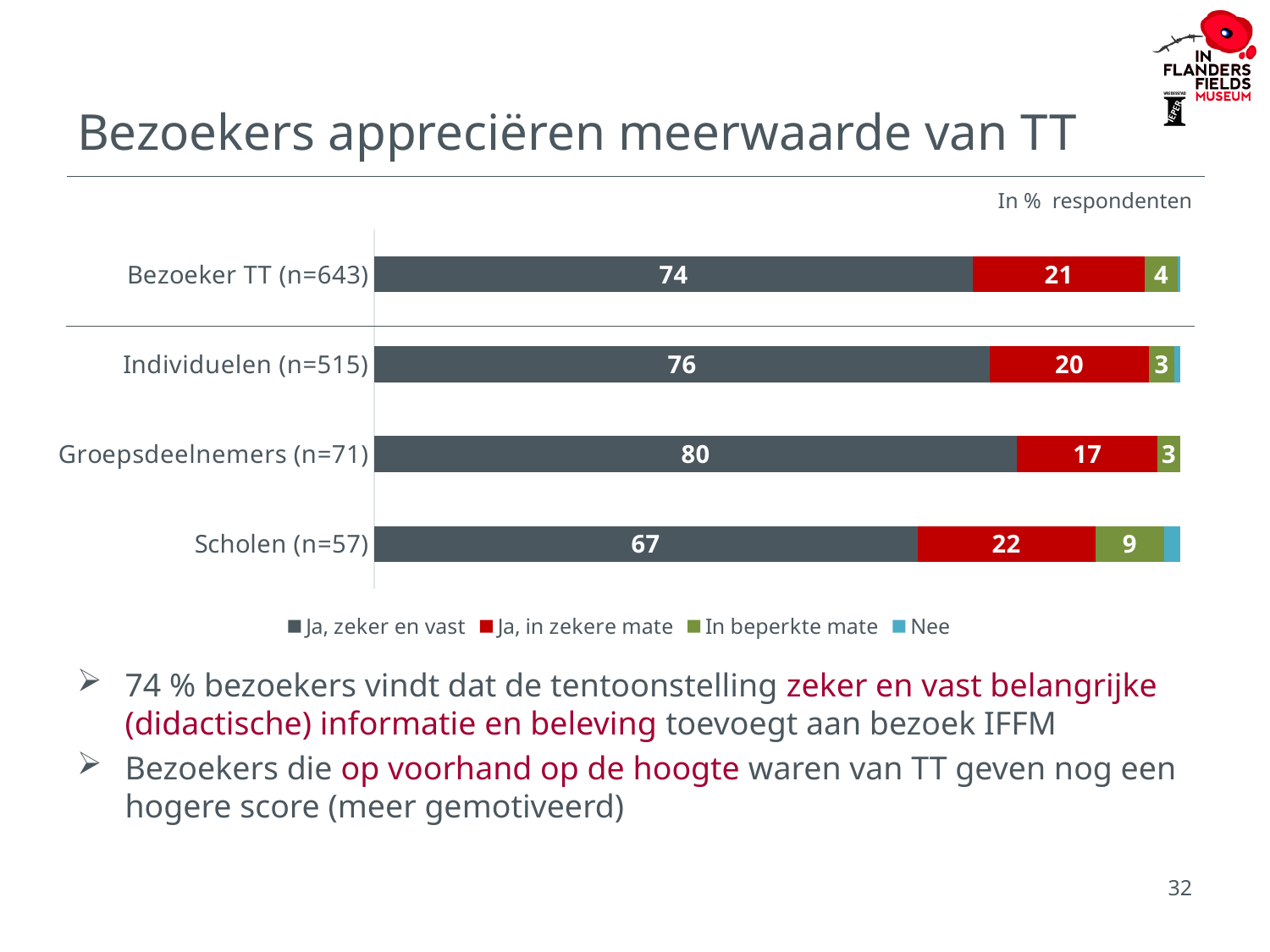
What is the value for "Ja, in zekere mate" for Scholen (n=57)? 22 Which category has the highest value for "Ja, zeker en vast"? Groepsdeelnemers (n=71) Which category has the lowest value for "Ja, zeker en vast"? Scholen (n=57) What is the value for "Ja, zeker en vast" for Bezoeker TT (n=643)? 74 What is the difference between the "Ja, zeker en vast" values for Groepsdeelnemers (n=71) and Scholen (n=57)? 13 What kind of chart is shown on the slide? Stacked bar chart How many series does the legend list? 4 What is the value for "Ja, in zekere mate" for Groepsdeelnemers (n=71)? 17 How many categories are shown on the chart? 4 Which series is shown in red in the chart? Ja, in zekere mate What is the value for "In beperkte mate" for Scholen (n=57)? 9 Which is larger: the "Ja, in zekere mate" value for Bezoeker TT (n=643) or for Individuelen (n=515)? Bezoeker TT (n=643)